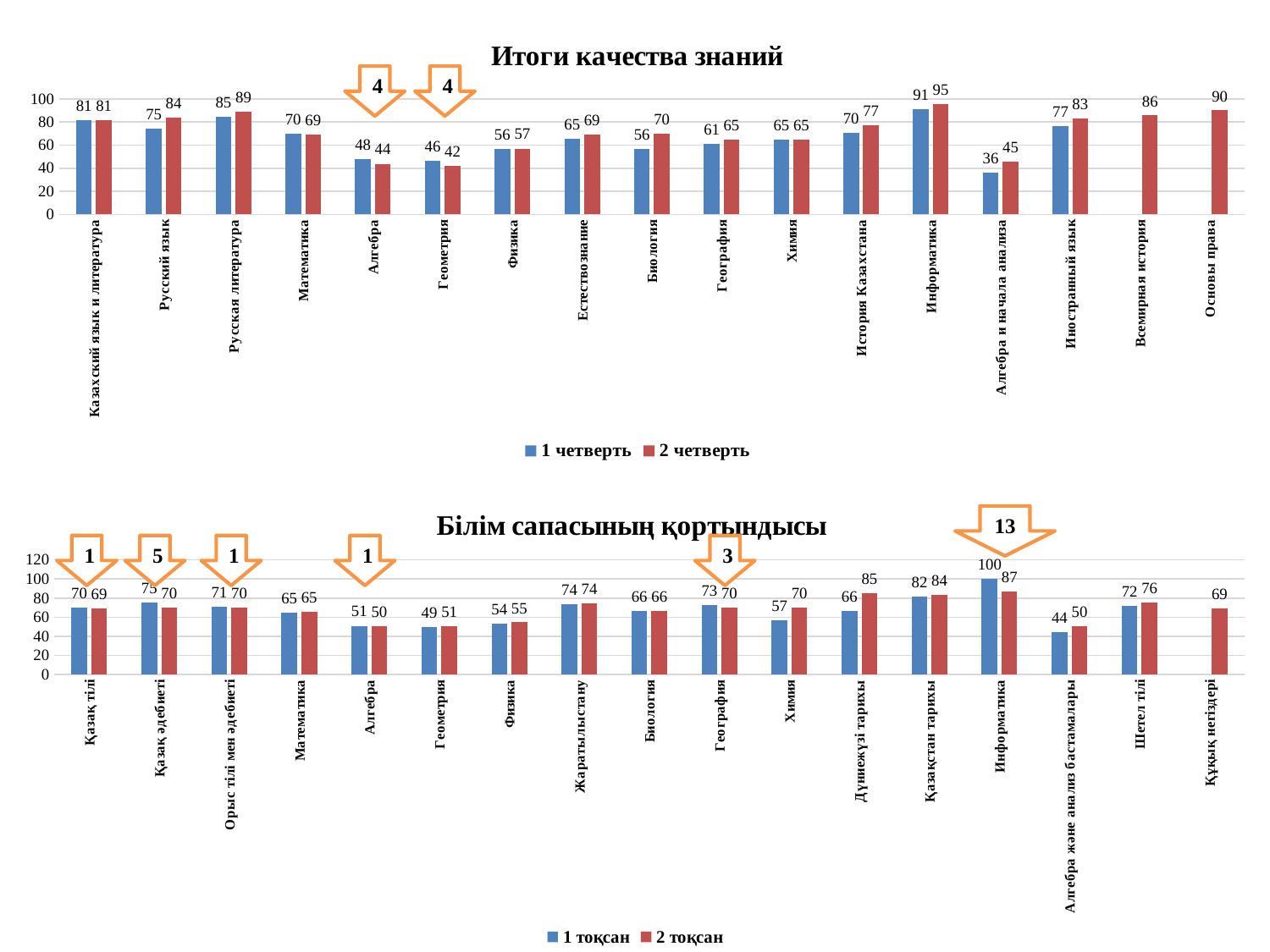
In the chart titled "Итоги качества знаний", what is the difference between the 2 четверть and 1 четверть values for Русский язык? 9 In the chart titled "Итоги качества знаний", how many series does the legend list? 2 In the chart titled "Итоги качества знаний", which is larger for Алгебра: the 1 четверть value or the 2 четверть value? 1 четверть In the chart titled "Білім сапасының қортындысы", what is the difference between the 2 тоқсан and 1 тоқсан values for Химия? 13 In the chart titled "Білім сапасының қортындысы", how many categories are shown on the x axis? 17 In the chart titled "Итоги качества знаний", what is the value for Информатика in 2 четверть? 95 In the chart titled "Білім сапасының қортындысы", what is the value for Алгебра және анализ бастамалары in 2 тоқсан? 50 In the chart titled "Итоги качества знаний", which category has the lowest value in 1 четверть? Алгебра и начала анализа What type of chart is the chart titled "Білім сапасының қортындысы"? Bar chart In the chart titled "Итоги качества знаний", what is the value for Геометрия in 1 четверть? 46 In the chart titled "Білім сапасының қортындысы", which category has the highest value in 2 тоқсан? Информатика In the chart titled "Білім сапасының қортындысы", what is the value for Информатика in 1 тоқсан? 100